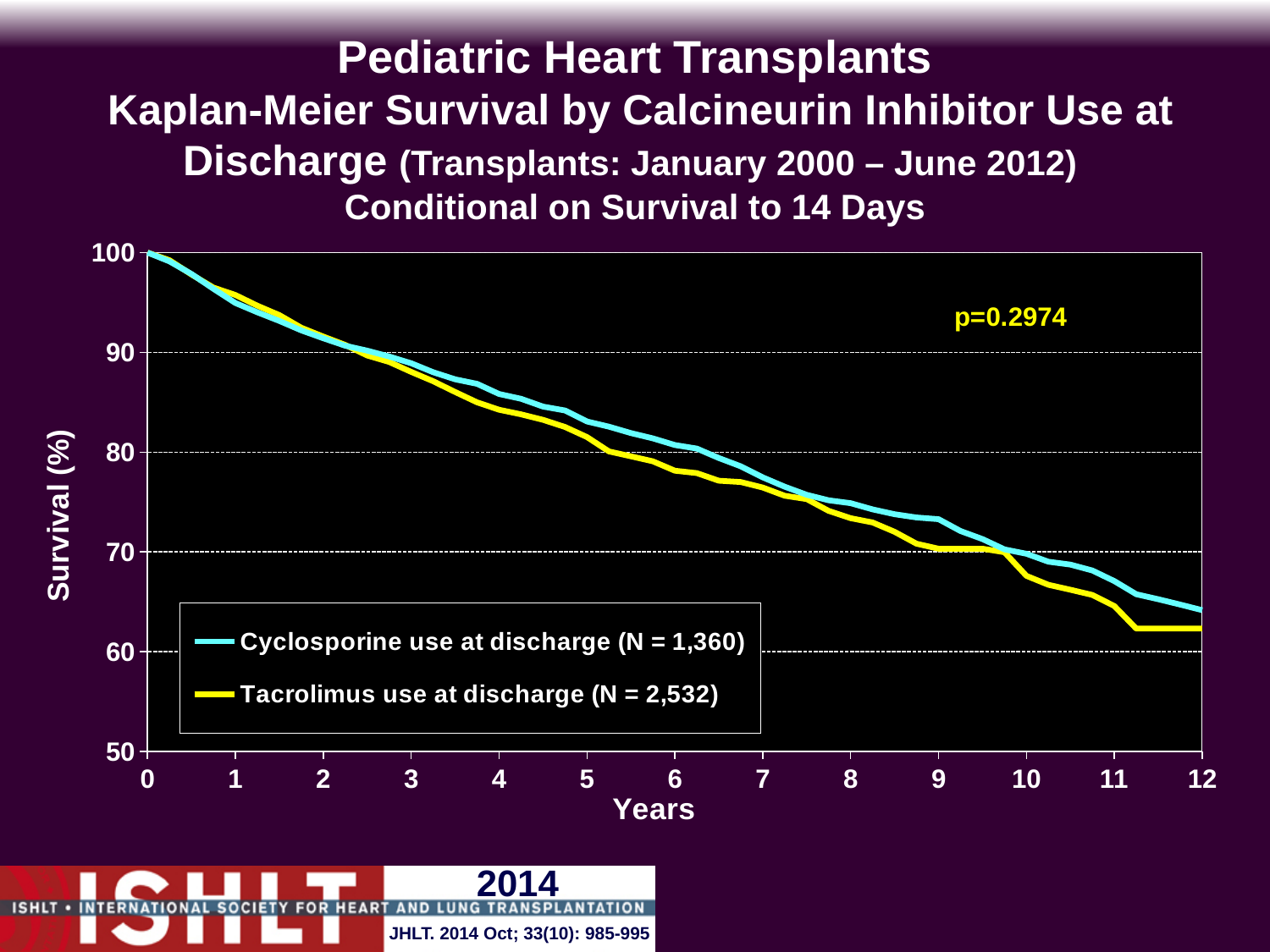
How many series does the legend list? 2 Is the survival value for Tacrolimus use at discharge at year 6 greater or less than 80? less What p-value is shown on the chart? p=0.2974 What is the N for the Tacrolimus use at discharge group? 2,532 Is the survival value for Tacrolimus use at discharge at year 12 greater or less than 60? greater At year 11, which group has the higher survival, Cyclosporine or Tacrolimus? Cyclosporine use at discharge Do the survival curves rise or fall as years increase? fall What is the N for the Cyclosporine use at discharge group? 1,360 Is the survival value for Cyclosporine use at discharge at year 9 greater or less than 70? greater What is the label of the y axis? Survival (%) What is the survival value for both groups at year 0? 100 What kind of chart is shown on the slide? line chart